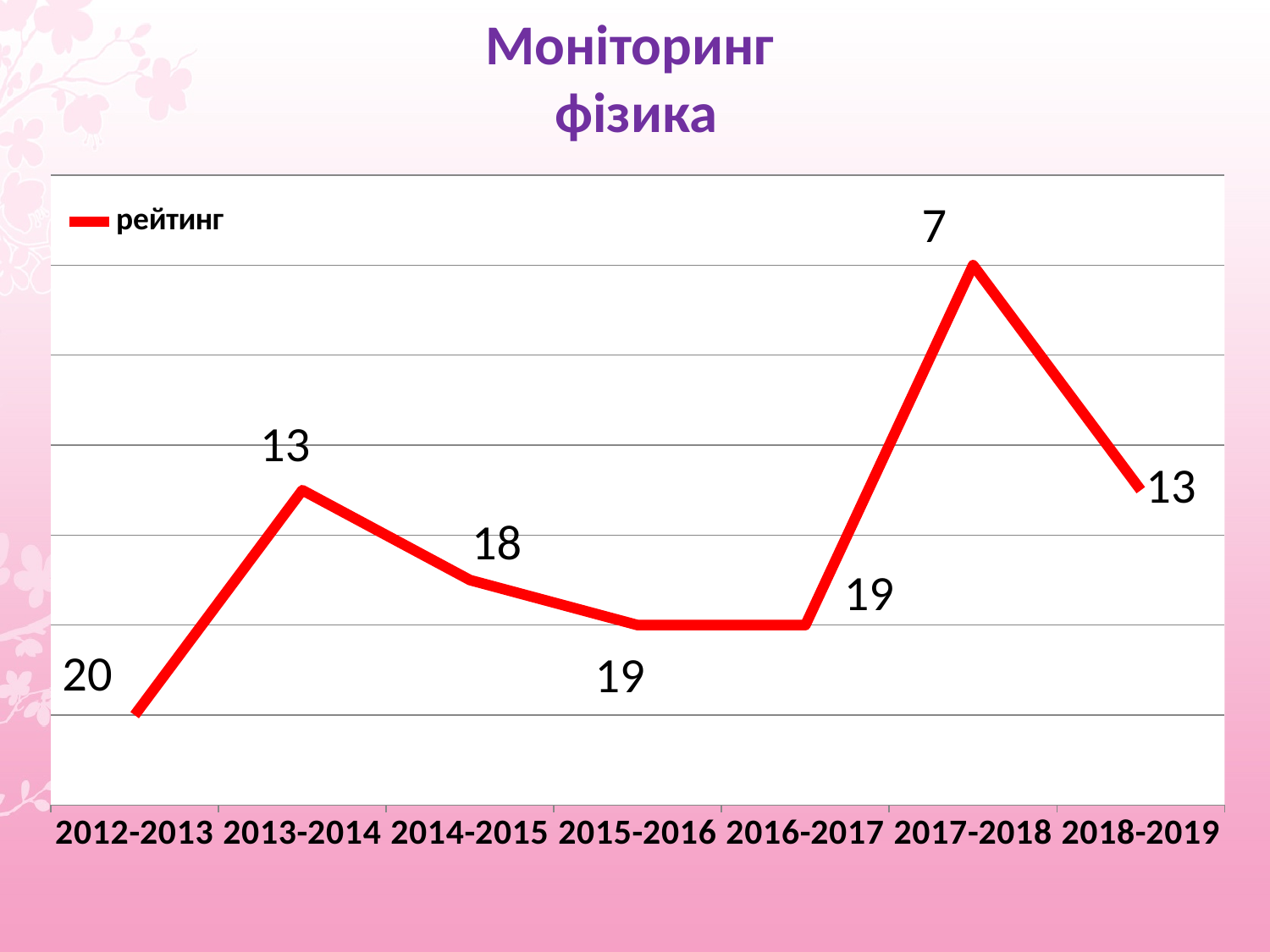
What is the difference between the values for 2012-2013 and 2017-2018? 13 What is the value for 2017-2018? 7 What is the value for 2012-2013? 20 What is the name of the series in the legend? рейтинг How many series does the legend list? 1 What is the value for 2014-2015? 18 What kind of chart is shown? line chart What is the value for 2018-2019? 13 How many years are plotted on the x axis? 7